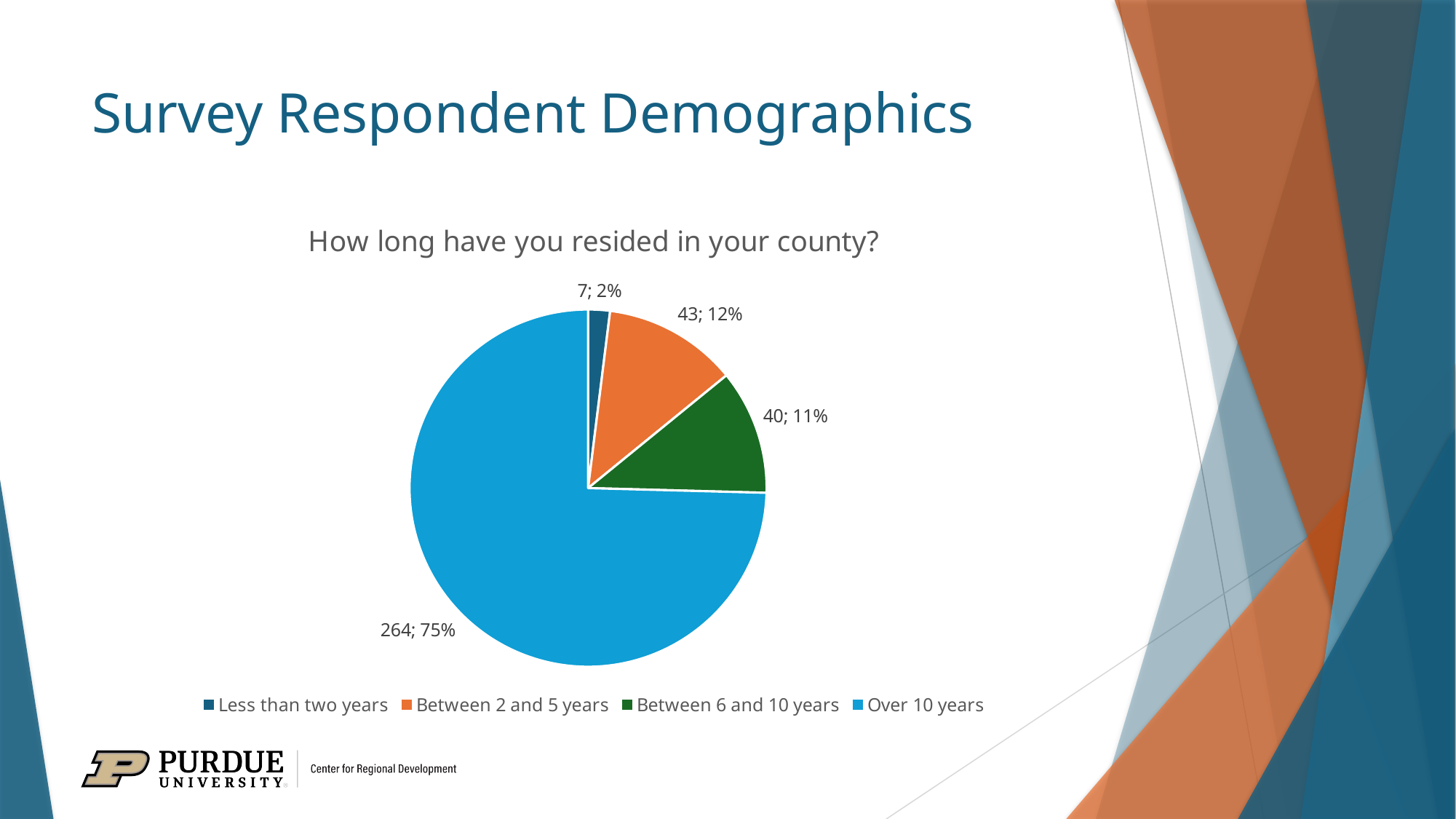
Which category has the smallest share of respondents? Less than two years How many categories does the legend list? 4 What is the difference in respondent count between 'Between 2 and 5 years' and 'Between 6 and 10 years'? 3 How many respondents have resided in their county for over 10 years? 264 What percentage of respondents have resided in their county between 2 and 5 years? 12% What percentage of respondents have resided in their county for less than two years? 2% How many respondents have resided in their county between 6 and 10 years? 40 Which has more respondents: 'Between 2 and 5 years' or 'Less than two years'? Between 2 and 5 years What type of chart is shown on the slide? pie chart Which category has the largest share of respondents? Over 10 years What is the title of the chart? How long have you resided in your county? What colour is the 'Over 10 years' slice? light blue